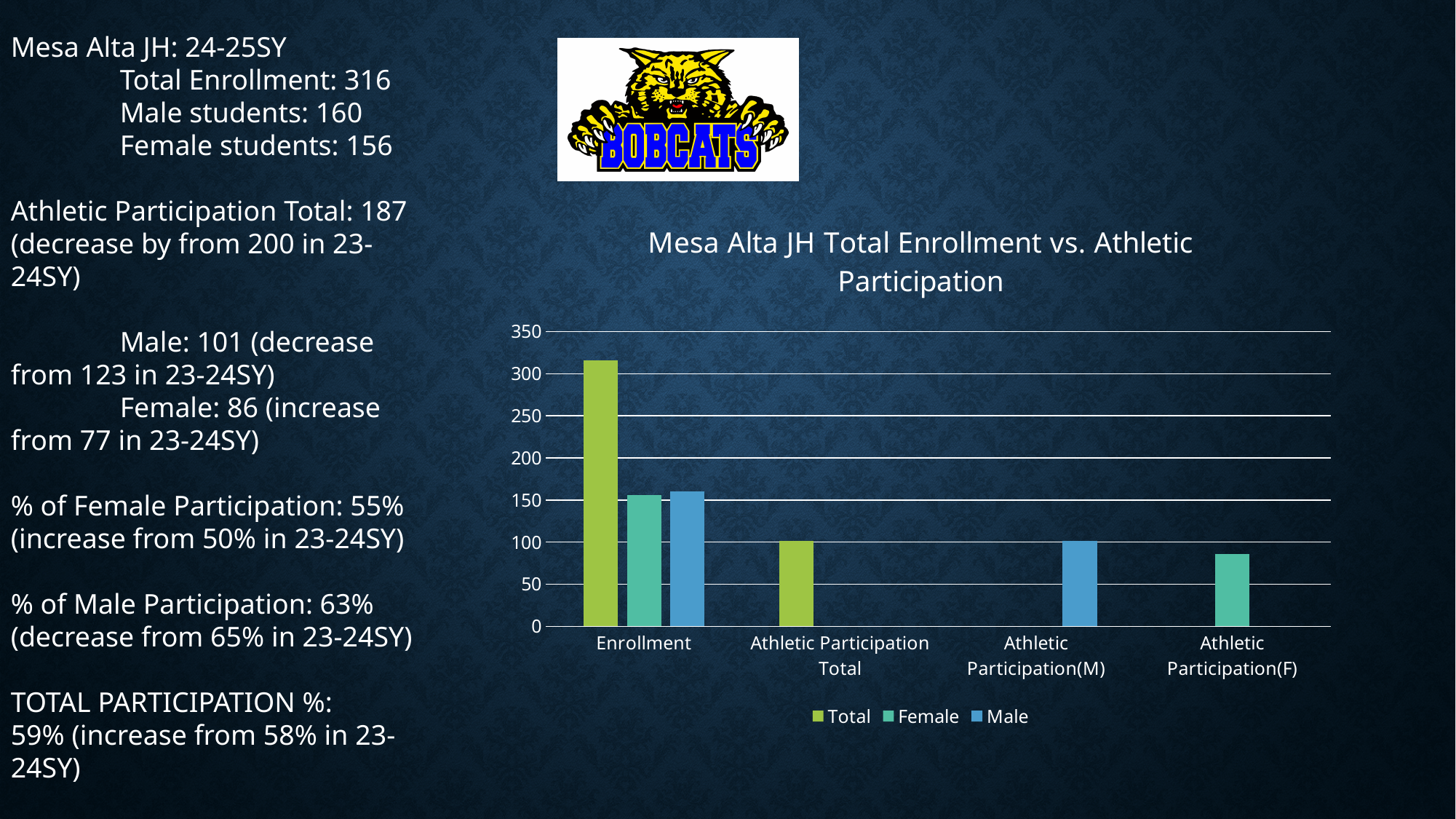
How many categories are shown on the x axis of the chart? 4 Is the Male bar for Enrollment greater or less than 100? greater What kind of chart is shown on the slide? bar chart Is the Total bar for Enrollment greater or less than 300? greater Is the Total bar for Athletic Participation Total greater or less than 150? less Which category has the tallest bar in the chart? Enrollment How many series does the chart legend list? 3 What is the title of the chart? Mesa Alta JH Total Enrollment vs. Athletic Participation Which is larger, the Male bar for Athletic Participation(M) or the Female bar for Athletic Participation(F)? Athletic Participation(M) Which is larger, the Total bar for Enrollment or the Total bar for Athletic Participation Total? Enrollment Which category has the shortest bar in the chart? Athletic Participation(F)